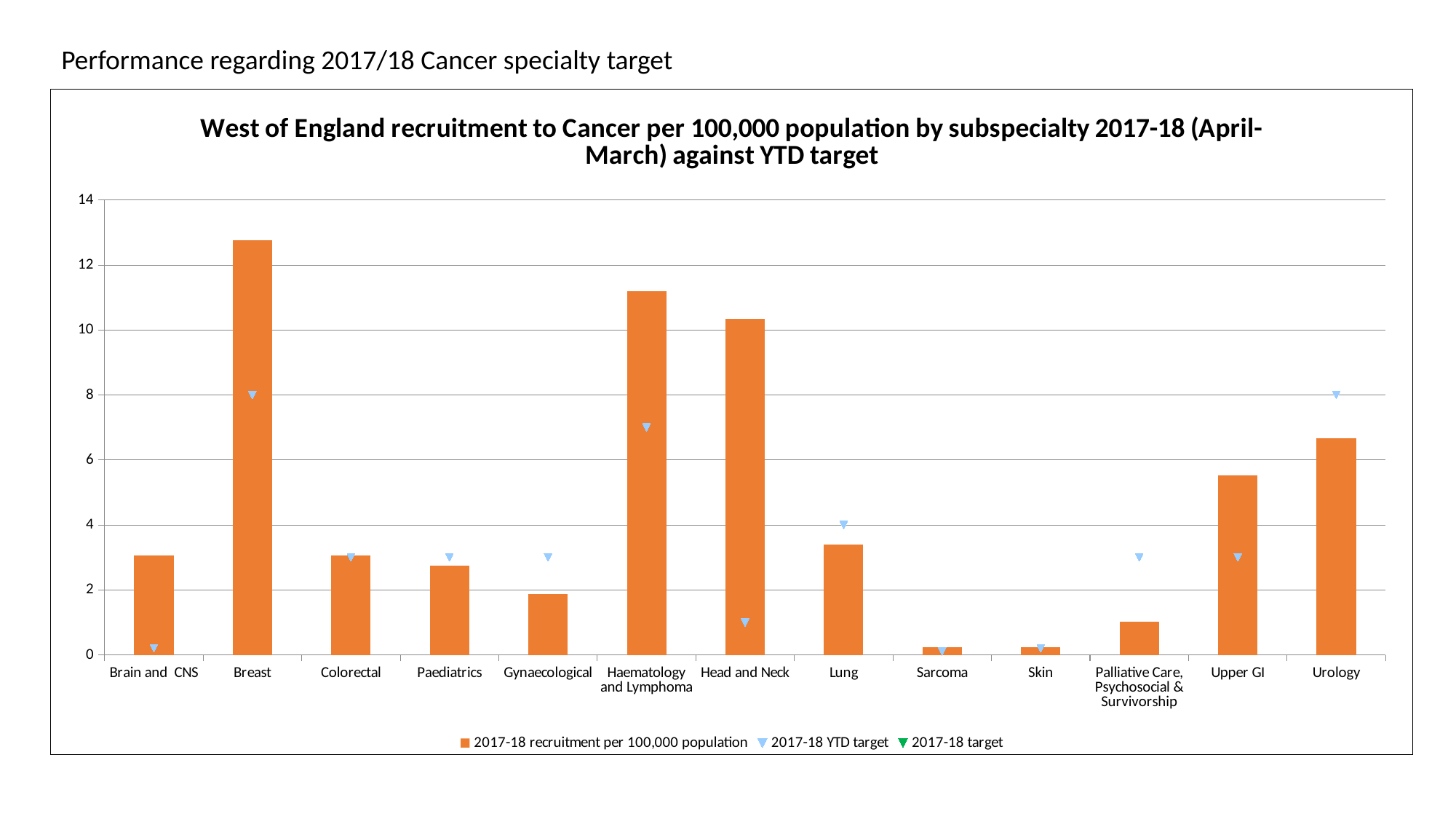
Is the 2017-18 recruitment per 100,000 population for Urology greater or less than 6? greater Is the 2017-18 recruitment per 100,000 population for Breast greater or less than 12? greater Which has the higher 2017-18 recruitment per 100,000 population, Upper GI or Urology? Urology Is the 2017-18 recruitment per 100,000 population for Gynaecological greater or less than 2? less What is the 2017-18 YTD target for Breast? 8 Which subspecialty has the highest 2017-18 recruitment per 100,000 population? Breast How many series does the legend list? 3 How many subspecialty categories are shown on the x axis? 13 What type of chart is shown on the slide? bar chart Which has the higher 2017-18 recruitment per 100,000 population, Haematology and Lymphoma or Head and Neck? Haematology and Lymphoma What colour are the bars for 2017-18 recruitment per 100,000 population? orange